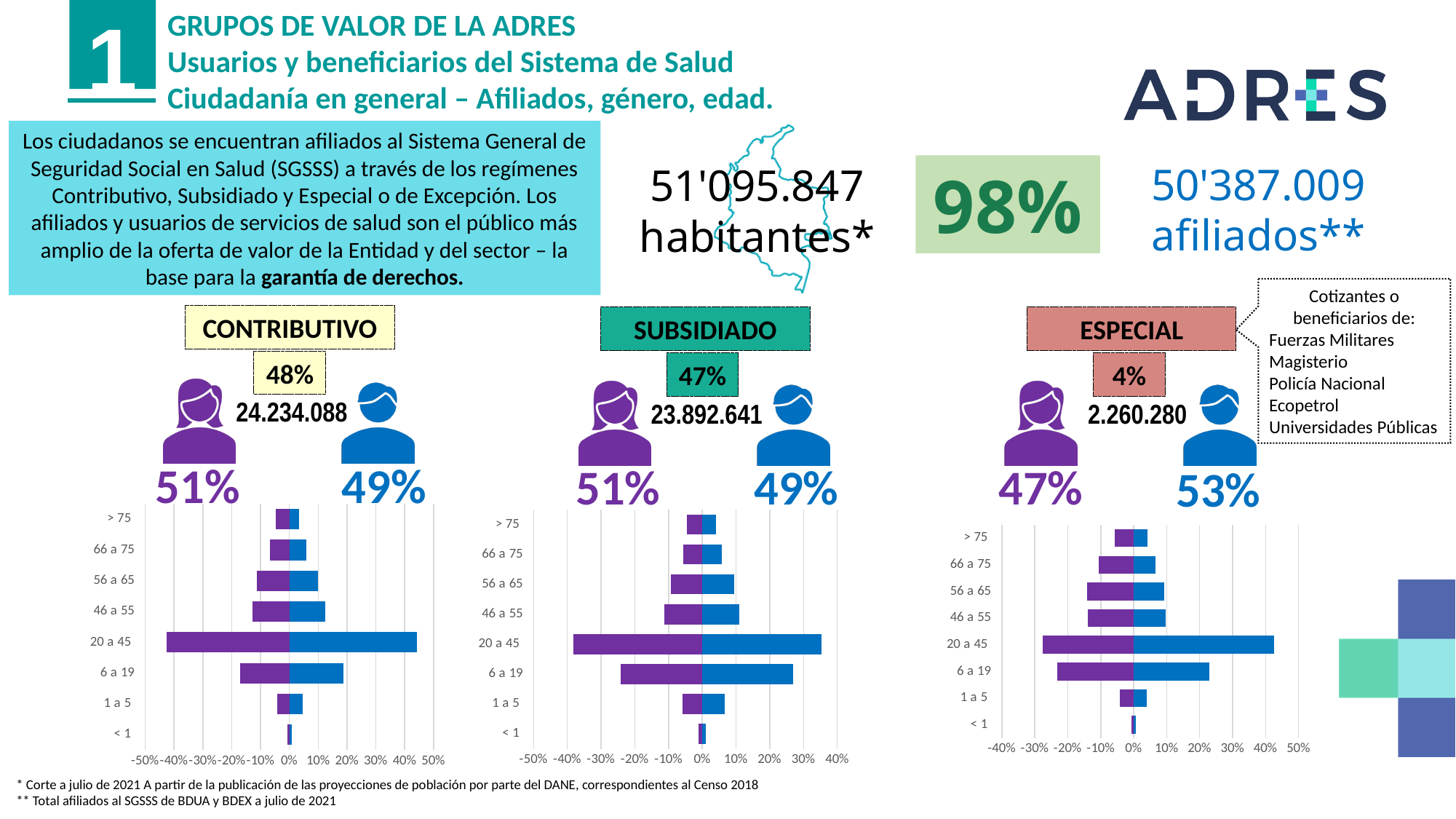
On the SUBSIDIADO chart, which age category has the longest bars? 20 a 45 On the CONTRIBUTIVO chart, which age category has a longer bar: 20 a 45 or 6 a 19? 20 a 45 On the ESPECIAL chart, is the right-hand (blue) bar for 6 a 19 greater or less than 10%? greater How many age categories are shown on the CONTRIBUTIVO chart? 8 On the CONTRIBUTIVO chart, is the right-hand (blue) bar for 20 a 45 greater or less than 30%? greater On the SUBSIDIADO chart, which age category has a longer bar: 46 a 55 or < 1? 46 a 55 What is the highest value shown on the horizontal axis of the SUBSIDIADO chart? 40% On the ESPECIAL chart, which age category has the shortest bars? < 1 On the ESPECIAL chart, which age category has a longer bar: 56 a 65 or 1 a 5? 56 a 65 What is the lowest value shown on the horizontal axis of the ESPECIAL chart? -40% What kind of chart is used under the CONTRIBUTIVO heading? bar chart On the SUBSIDIADO chart, is the right-hand (blue) bar for > 75 greater or less than 10%? less